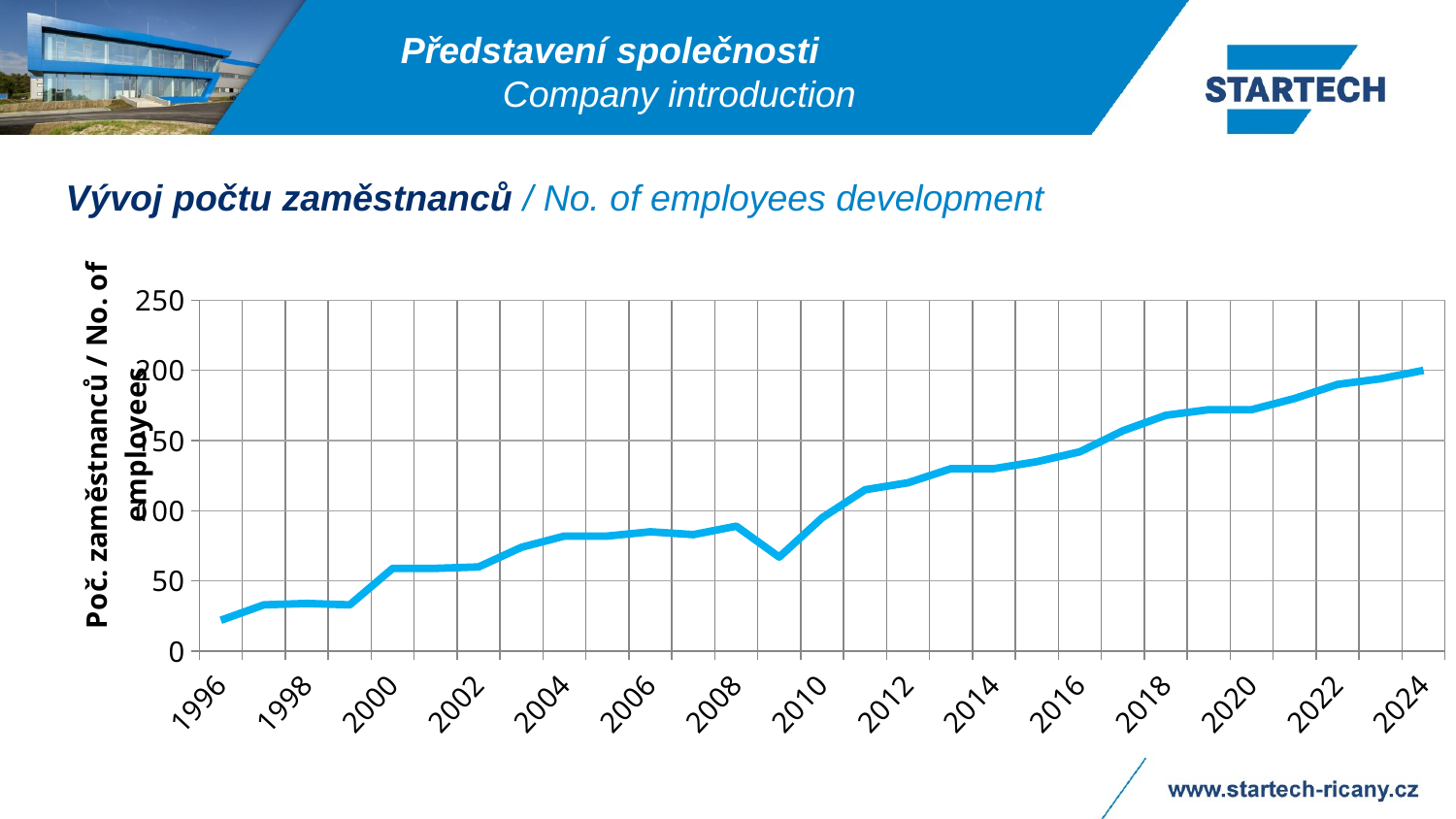
Which year shown on the x axis has the highest number of employees? 2024 Which year shown on the x axis has the lowest number of employees? 1996 Is the number of employees in 2022 greater or less than 200? less What is the English part of the chart's title on the slide? No. of employees development How many year labels are shown on the x axis? 15 What kind of chart is shown on the slide? line chart Is the number of employees in 2004 greater or less than 100? less Which year had more employees, 2008 or 2009? 2008 Is the number of employees in 2014 greater or less than 100? greater What is the overall trend in the number of employees from 1996 to 2024? rising